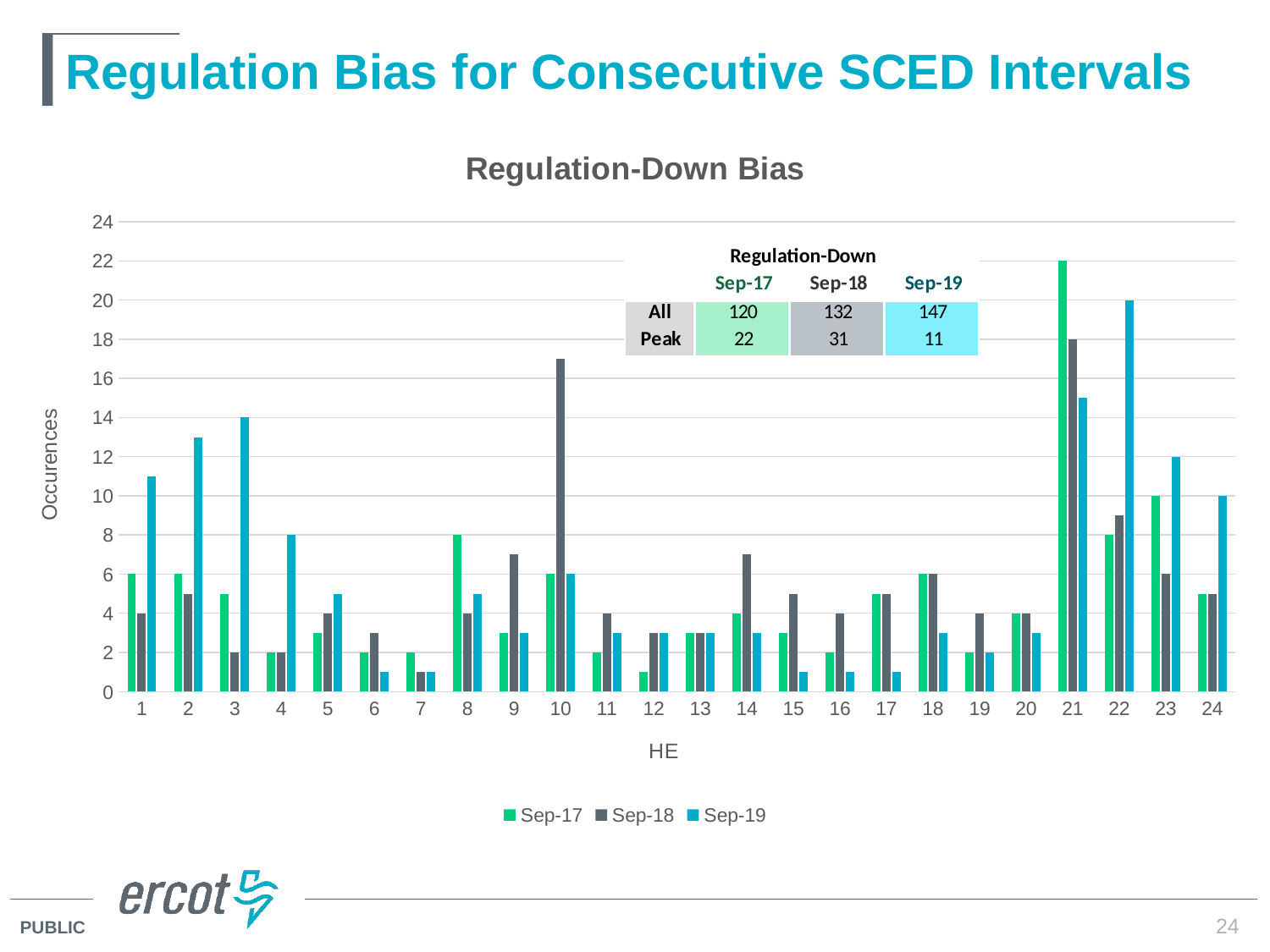
According to the inset table, what is the 'Peak' value for Sep-18? 31 In the inset table, which month has the lowest 'Peak' value? Sep-19 In the inset table, what is the difference between the 'All' values for Sep-19 and Sep-17? 27 Which HE has the tallest Sep-17 bar? 21 Is the Sep-18 bar for HE 10 greater or less than 14? greater How many HE categories are shown on the x axis? 24 In the inset table, which month has the highest 'All' value? Sep-19 What type of chart is shown on the slide? bar chart How many series does the legend list? 3 According to the inset table, what is the 'All' value for Sep-19? 147 What is the title of the chart? Regulation-Down Bias Is the Sep-19 bar for HE 22 greater or less than the Sep-19 bar for HE 21? greater